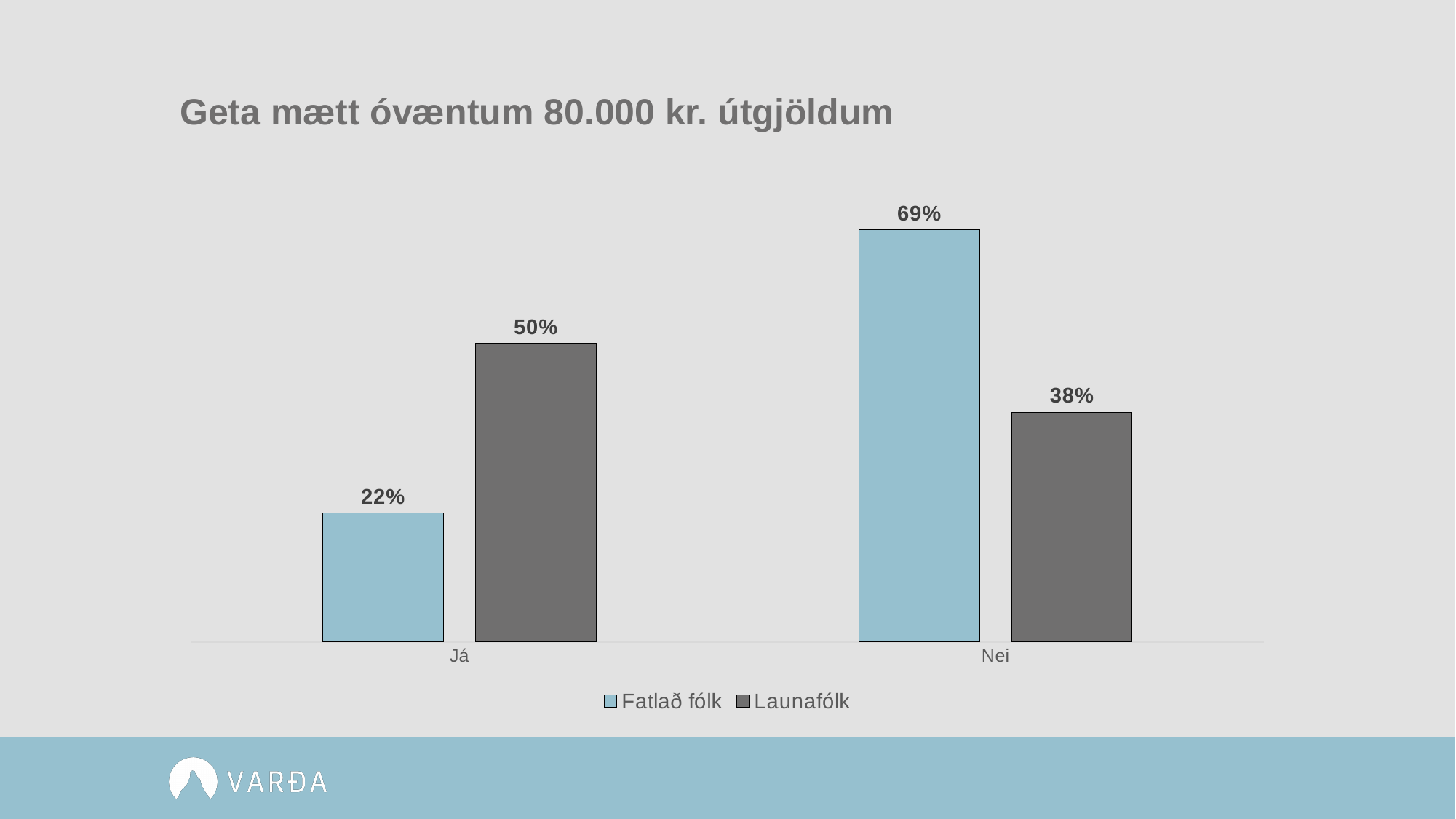
What is the difference between Fatlað fólk and Launafólk in the Nei category? 31 percentage points Which bar has the lowest value on the chart? Fatlað fólk, Já What is the value for Fatlað fólk in the Já category? 22% What is the value for Fatlað fólk in the Nei category? 69% Which is larger in the Nei category, Fatlað fólk or Launafólk? Fatlað fólk How many series does the legend list? 2 How many categories are shown on the x axis? 2 What is the difference between Launafólk and Fatlað fólk in the Já category? 28 percentage points Which bar has the highest value on the chart? Fatlað fólk, Nei What is the value for Launafólk in the Já category? 50% What is the value for Launafólk in the Nei category? 38% What kind of chart is shown on the slide? Bar chart